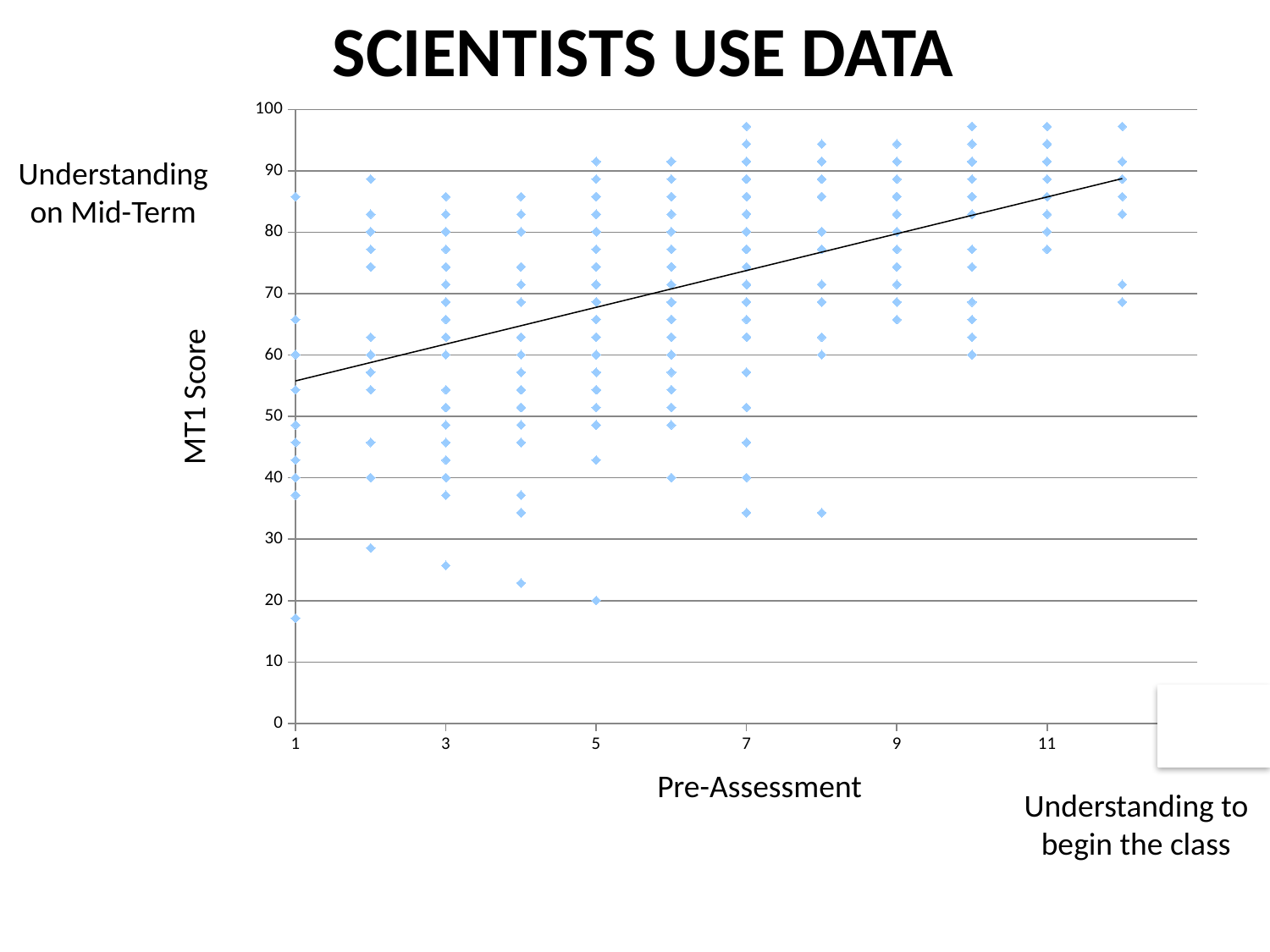
Is the lowest MT1 Score plotted at Pre-Assessment 11 greater or less than 70? greater Is the value of the trend line at Pre-Assessment 1 greater or less than 50? greater What is the title of the chart's y axis? MT1 Score Is the highest MT1 Score plotted at Pre-Assessment 12 greater or less than 90? greater What kind of chart is shown on the slide? Scatter chart What is the maximum value shown on the y axis? 100 Do the MT1 scores generally rise or fall as the Pre-Assessment score increases along the x axis? Rise What is the title of the chart's x axis? Pre-Assessment